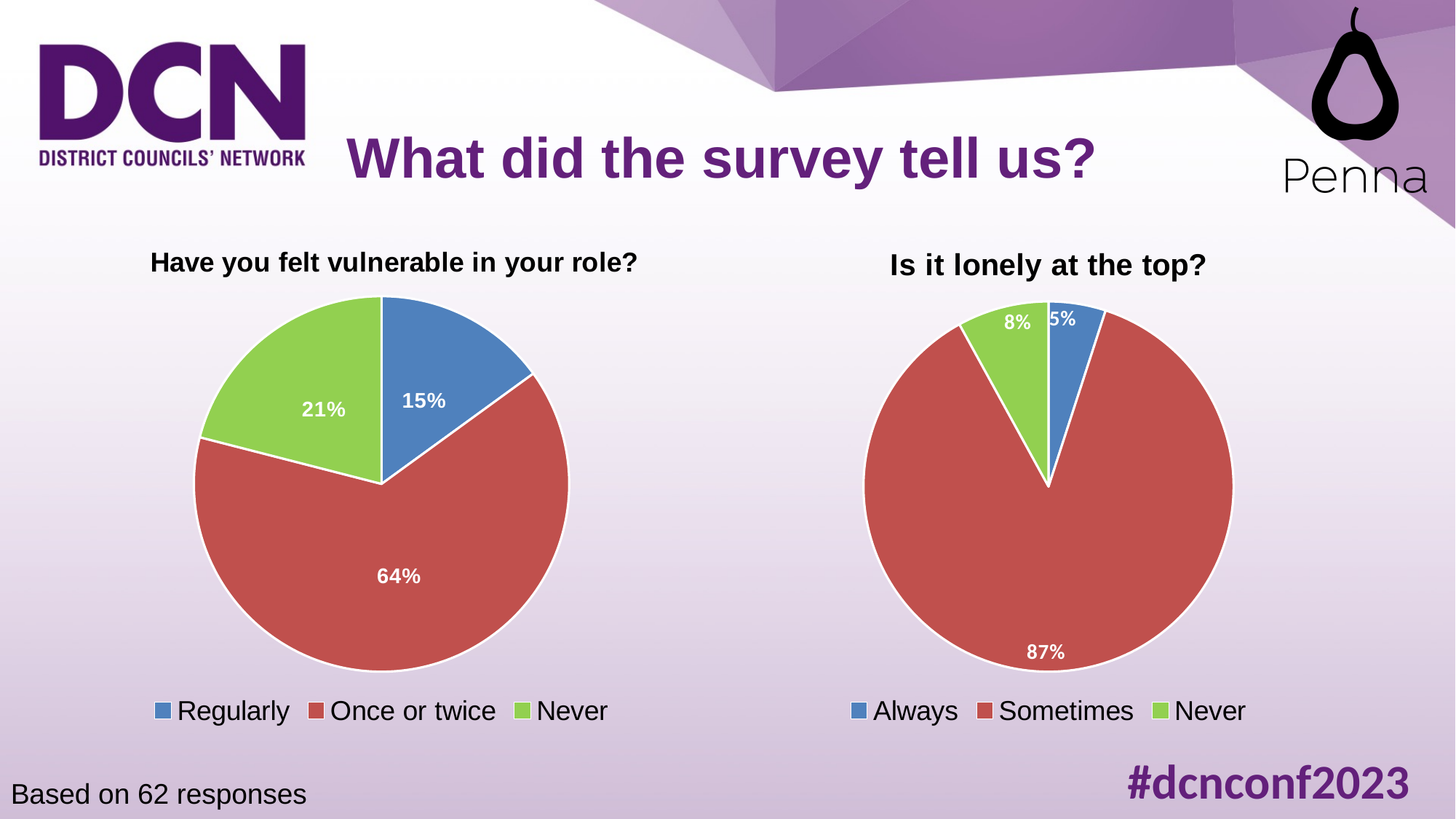
According to the slide, how many responses are the charts based on? 62 responses In the 'Is it lonely at the top?' chart, what share of respondents answered 'Always'? 5% In the 'Have you felt vulnerable in your role?' chart, what is the difference in percentage points between 'Never' and 'Regularly'? 6 percentage points How many categories does the legend of the 'Have you felt vulnerable in your role?' chart list? 3 In the 'Have you felt vulnerable in your role?' chart, what share of respondents answered 'Once or twice'? 64% In the 'Have you felt vulnerable in your role?' chart, what share of respondents answered 'Never'? 21% In the 'Have you felt vulnerable in your role?' chart, which response has the largest slice? Once or twice What type of chart is used for 'Is it lonely at the top?'? Pie chart In the 'Is it lonely at the top?' chart, what share of respondents answered 'Sometimes'? 87% In the 'Have you felt vulnerable in your role?' chart, what share of respondents answered 'Regularly'? 15% In the 'Is it lonely at the top?' chart, which is larger, 'Never' or 'Always'? Never In the 'Is it lonely at the top?' chart, which response has the smallest slice? Always